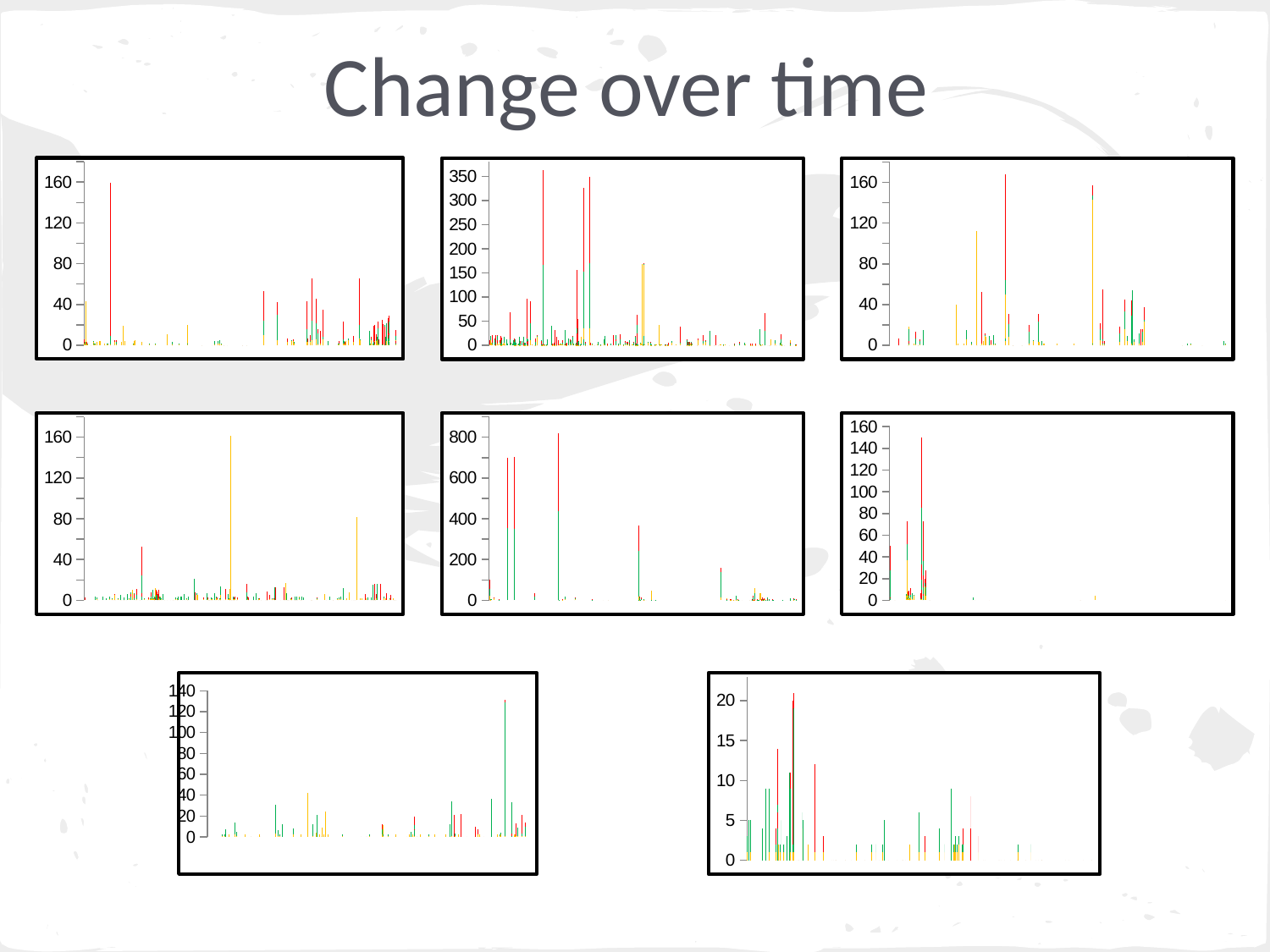
In the middle-right chart, is the tallest bar greater or less than 100? greater In the bottom-right chart, is the tallest bar greater or less than 15? greater In the middle-center chart, is the tallest bar greater or less than 600? greater What kind of chart is the bottom-right chart on the slide? bar chart How many charts are shown on the slide? 8 What kind of chart is the top-left chart on the slide? bar chart What is the title of the slide? Change over time